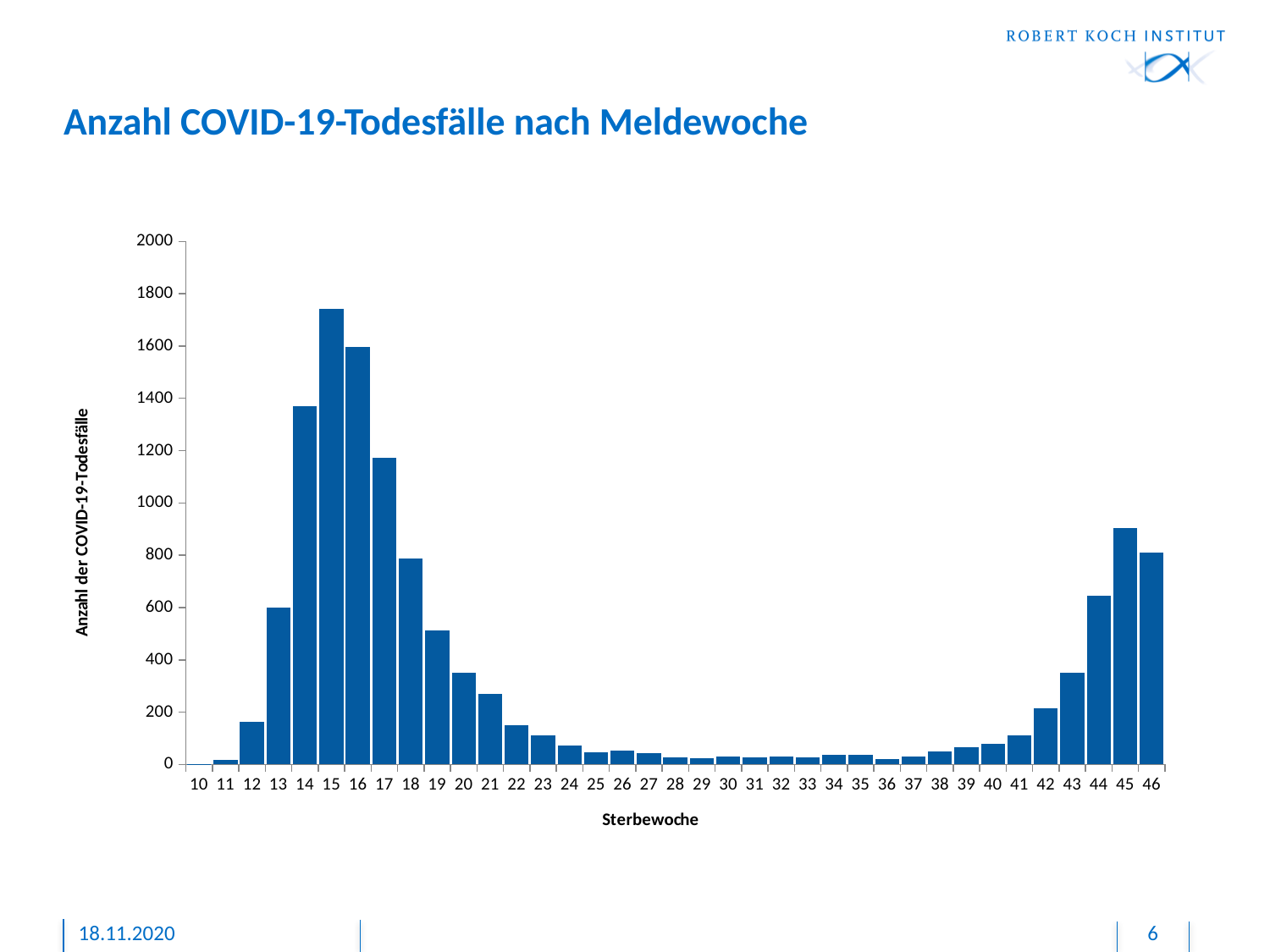
What kind of chart is shown on the slide? bar chart Which Sterbewoche has the highest number of COVID-19 deaths? 15 Is the value for week 20 greater or less than 400? less Which week has the larger value, week 14 or week 16? 16 Is the value for week 15 greater or less than 1600? greater Is the value for week 44 greater or less than 600? greater Do the values rise or fall from week 15 to week 30? fall Which week has the larger value, week 45 or week 46? 45 How many weeks (categories) are shown on the x axis? 37 What is the label of the x axis? Sterbewoche